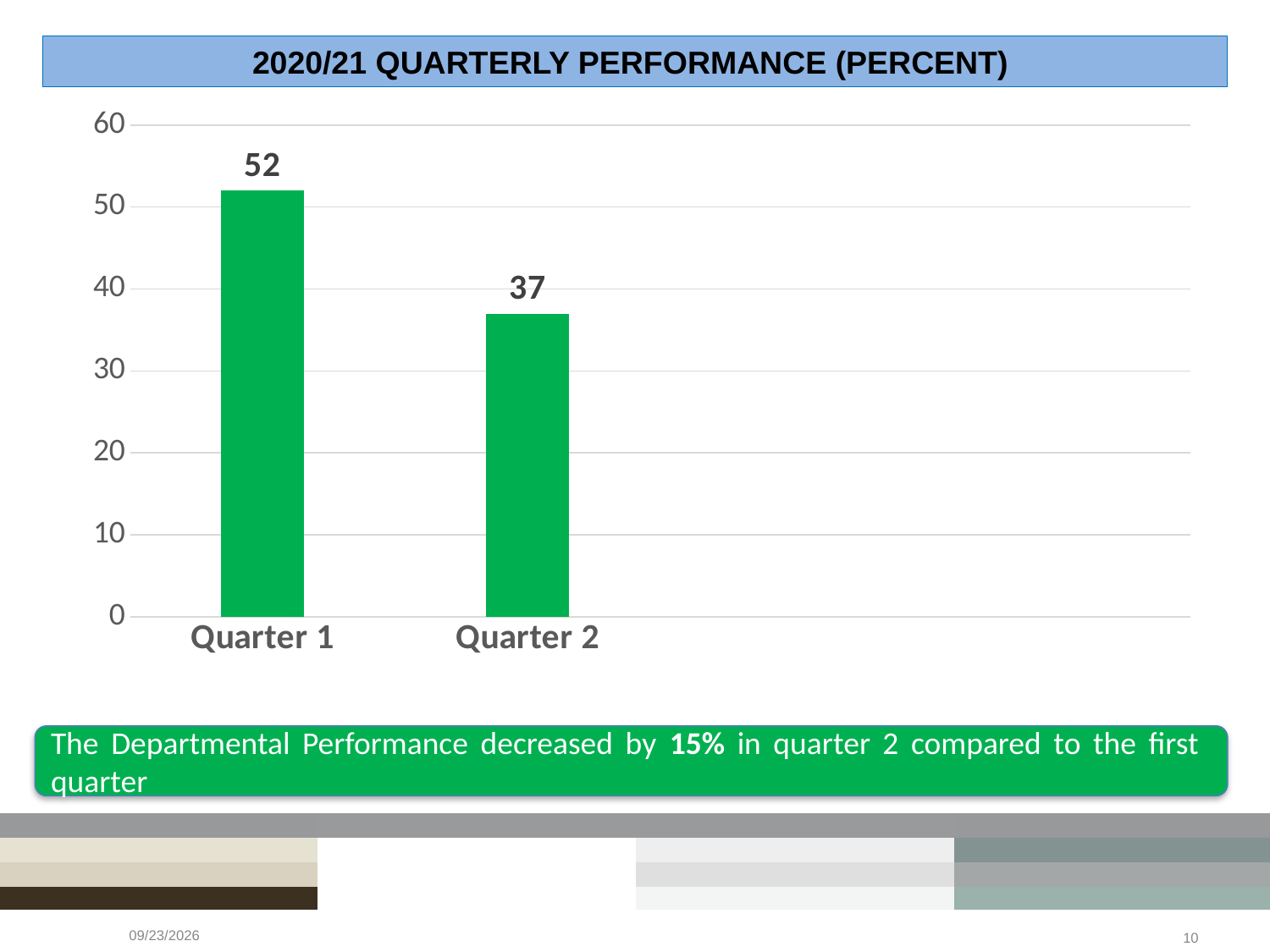
Is the value for Quarter 1 greater or less than 50? greater Do the values rise or fall from Quarter 1 to Quarter 2? fall Which is larger, the value for Quarter 1 or Quarter 2? Quarter 1 Which quarter has the lowest value? Quarter 2 What is the difference between the values for Quarter 1 and Quarter 2? 15 Is the value for Quarter 2 greater or less than 40? less What is the value for Quarter 2? 37 What kind of chart is shown on the slide? bar chart What is the title of the chart? 2020/21 QUARTERLY PERFORMANCE (PERCENT) How many categories are shown on the chart? 2 Which quarter has the highest value? Quarter 1 What is the value for Quarter 1? 52